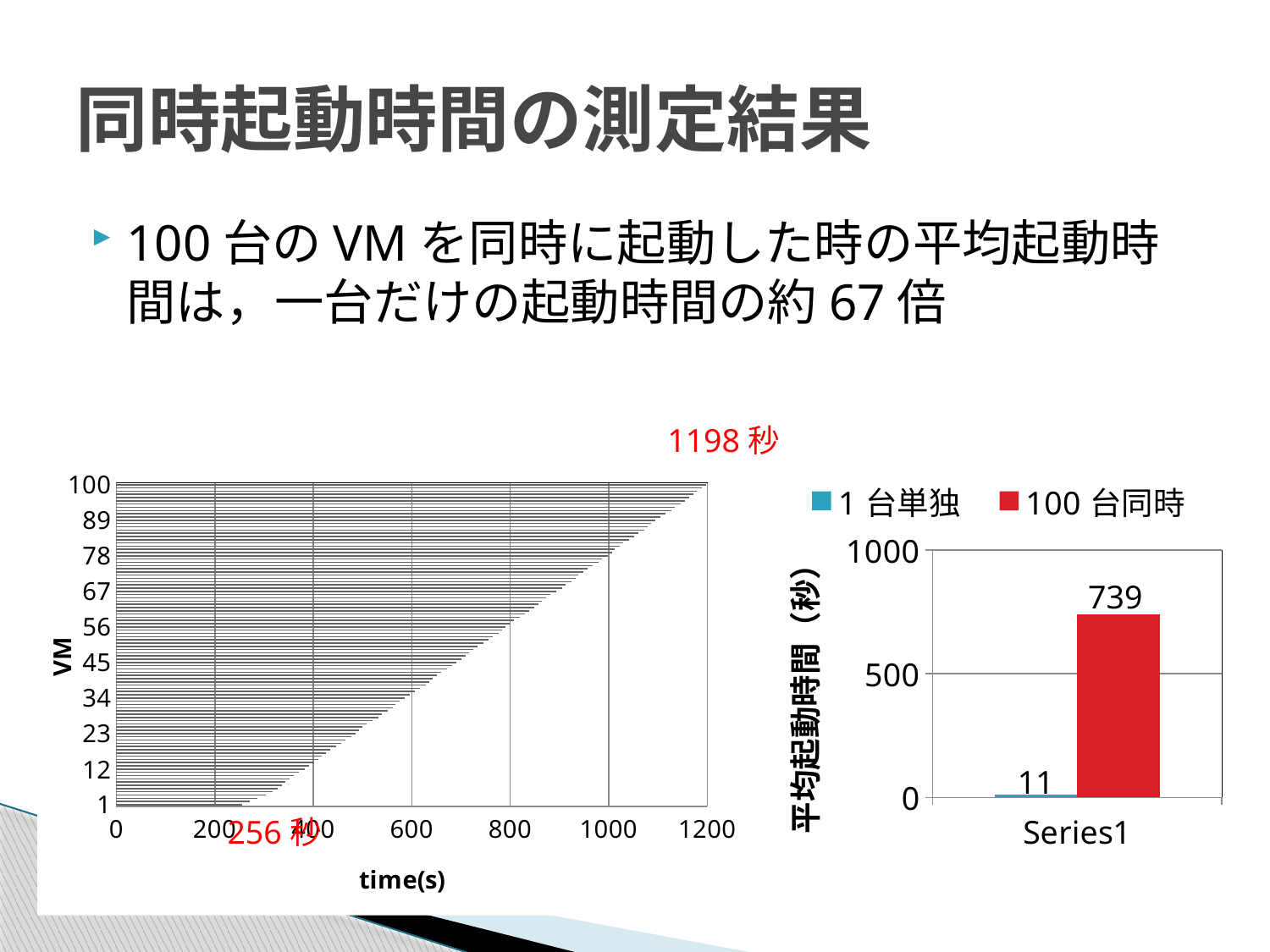
In the right chart, how many series does the legend list? 2 In the right chart, what is the value for 1 台単独? 11 In the right chart, what is the difference between the 100 台同時 value and the 1 台単独 value? 728 In the left chart, is the time value for VM 1 greater or less than 400? less In the left chart, do the time values rise or fall as the VM number increases from 1 to 100? rise In the right chart, is the value for 100 台同時 greater or less than 500? greater In the right chart, what is the value for 100 台同時? 739 What kind of chart is the left chart? bar chart What is the x-axis title of the left chart? time(s) What kind of chart is the right chart? bar chart In the right chart, which series has the larger value, 1 台単独 or 100 台同時? 100 台同時 In the left chart, is the time value for VM 100 greater or less than 1000? greater